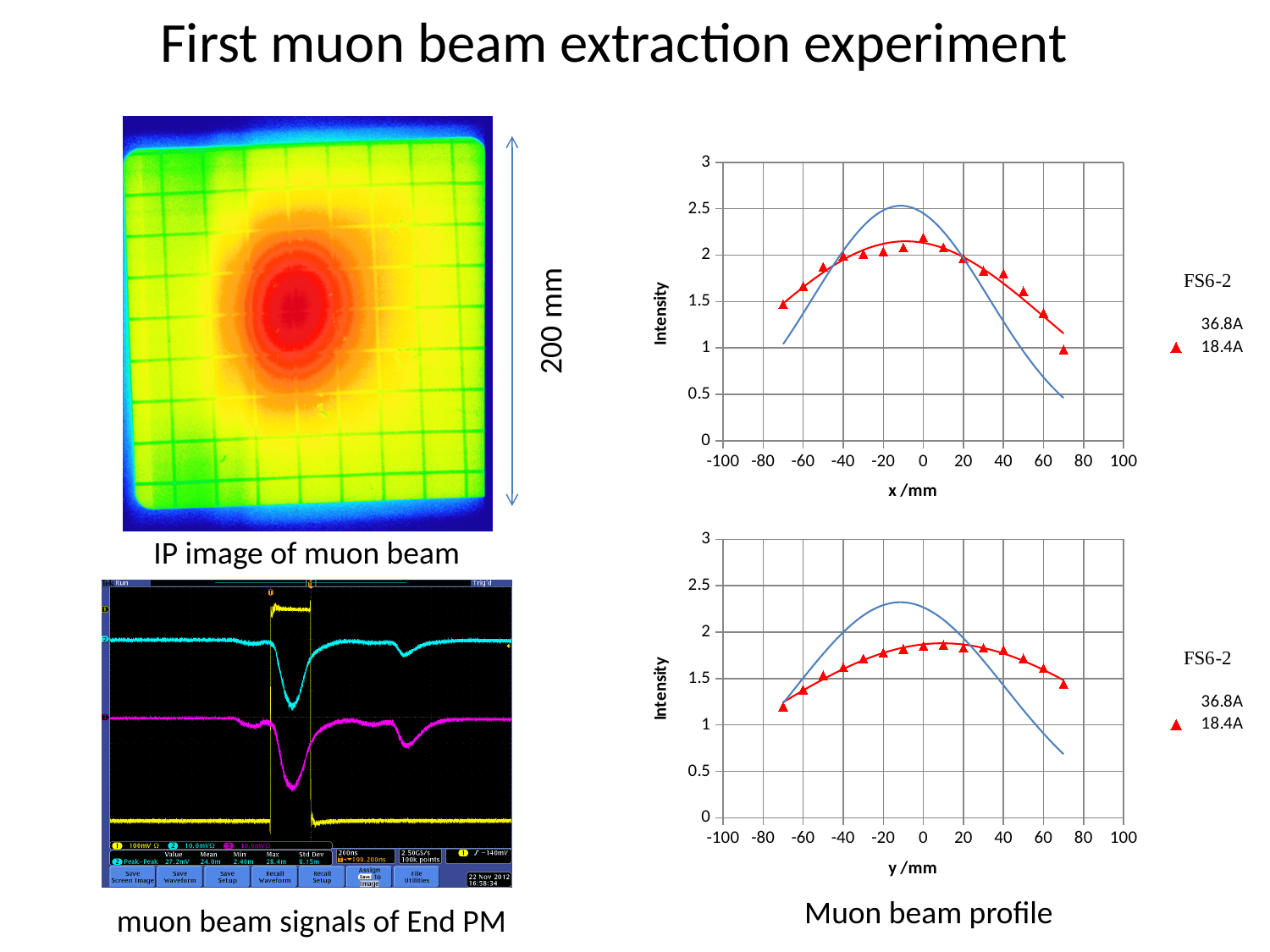
In the bottom chart (Intensity vs y /mm), which series has the higher intensity at y = -20, 36.8A or 18.4A? 36.8A In the bottom chart (Intensity vs y /mm), do the 18.4A values rise or fall as y goes from -70 to 10? rise In the top chart (Intensity vs x /mm), is the 18.4A value at x = -60 greater or less than 1.5? greater In the bottom chart (Intensity vs y /mm), is the 18.4A value at y = -70 greater or less than 1.5? less In the top chart (Intensity vs x /mm), is the peak of the 36.8A curve greater or less than 2? greater In the top chart (Intensity vs x /mm), how many data series does the legend list? 2 In the top chart (Intensity vs x /mm), which series reaches the higher peak intensity? 36.8A In the top chart (Intensity vs x /mm), which series has the higher intensity at x = 60, 36.8A or 18.4A? 18.4A What kind of chart is the top chart on the right (Intensity vs x /mm)? scatter chart with fitted lines In the top chart (Intensity vs x /mm), what is the label of the horizontal axis? x /mm In the bottom chart (Intensity vs y /mm), what are the two series named in the legend? 36.8A and 18.4A